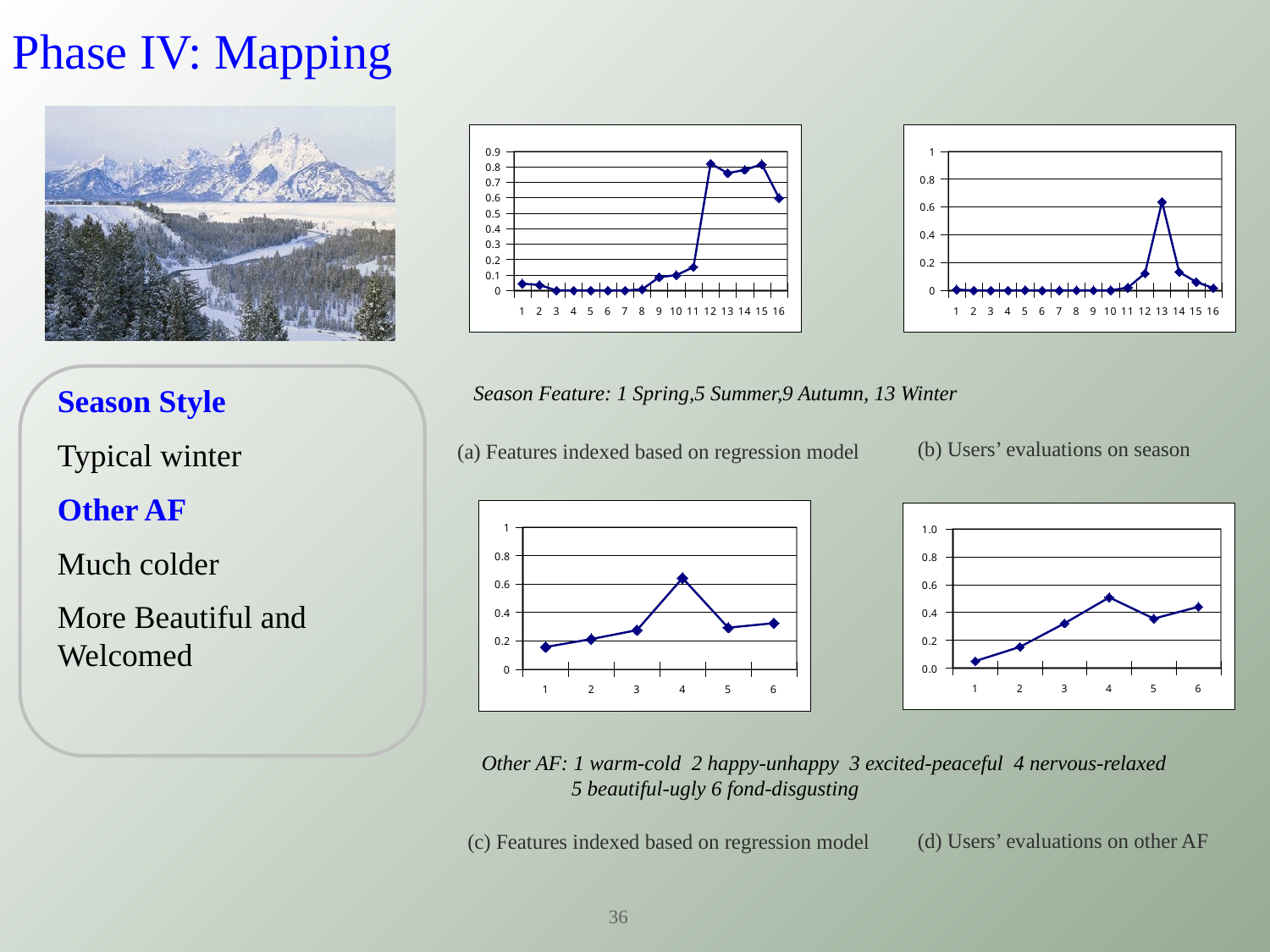
What kind of chart is chart (a), 'Features indexed based on regression model' for season? line chart In chart (d), the bottom-right chart, is the value at x = 1 greater or less than 0.2? less In chart (c), the bottom-left chart, which x value has the highest point? 4 In chart (b), the top-right chart, is the value at x = 13 greater or less than 0.4? greater In chart (d), the bottom-right chart, do the values rise or fall from x = 1 to x = 4? rise How many points are plotted along the x axis in chart (c), the bottom-left chart? 6 How many points are plotted along the x axis in chart (a), the top-left chart? 16 In chart (c), the bottom-left chart, which is larger, the value at x = 1 or at x = 6? 6 In chart (a), the top-left chart, is the value at x = 11 greater or less than 0.3? less In chart (b), 'Users' evaluations on season', which x value has the highest point? 13 In chart (d), 'Users' evaluations on other AF', which x value has the lowest point? 1